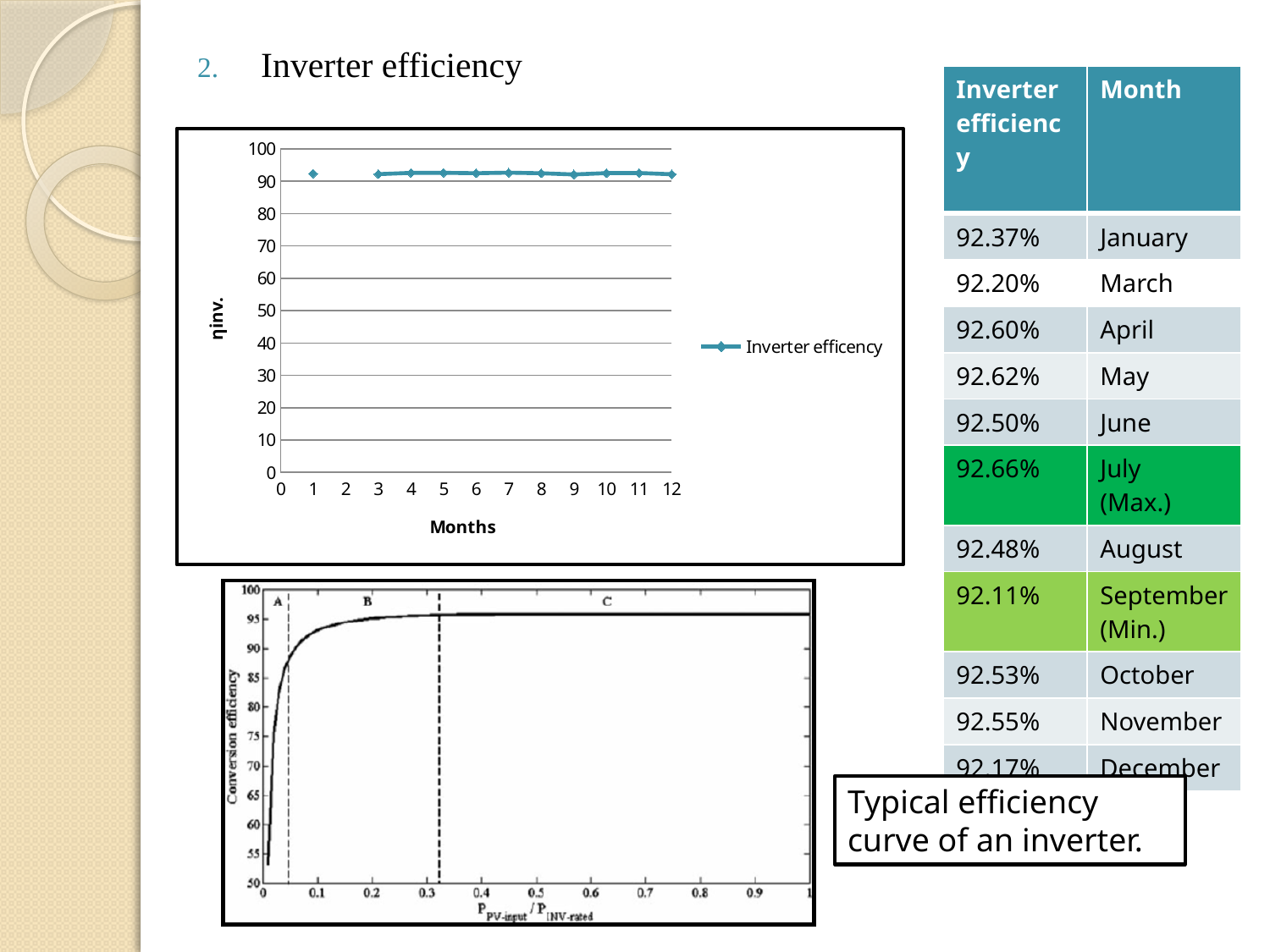
According to the inverter efficiency table, which month has the highest inverter efficiency? July According to the inverter efficiency table, which month has the lowest inverter efficiency? September In the bottom chart (typical efficiency curve of an inverter), what is the label of the y axis? Conversion efficiency According to the inverter efficiency table, what is the inverter efficiency for April? 92.60% In the top Inverter efficiency chart, is the value at month 12 greater or less than 100? less In the top Inverter efficiency chart, how many data points are plotted? 11 In the top Inverter efficiency chart, how many series does the legend list? 1 In the bottom chart (typical efficiency curve of an inverter), is the conversion efficiency at a power ratio of 0.5 greater or less than 90? greater According to the inverter efficiency table, which is larger, the inverter efficiency for May or for March? May What kind of chart is the top chart showing inverter efficiency by month? line chart According to the inverter efficiency table, what is the difference between the July and September inverter efficiencies? 0.55% In the top Inverter efficiency chart, is the value at month 5 greater or less than 90? greater